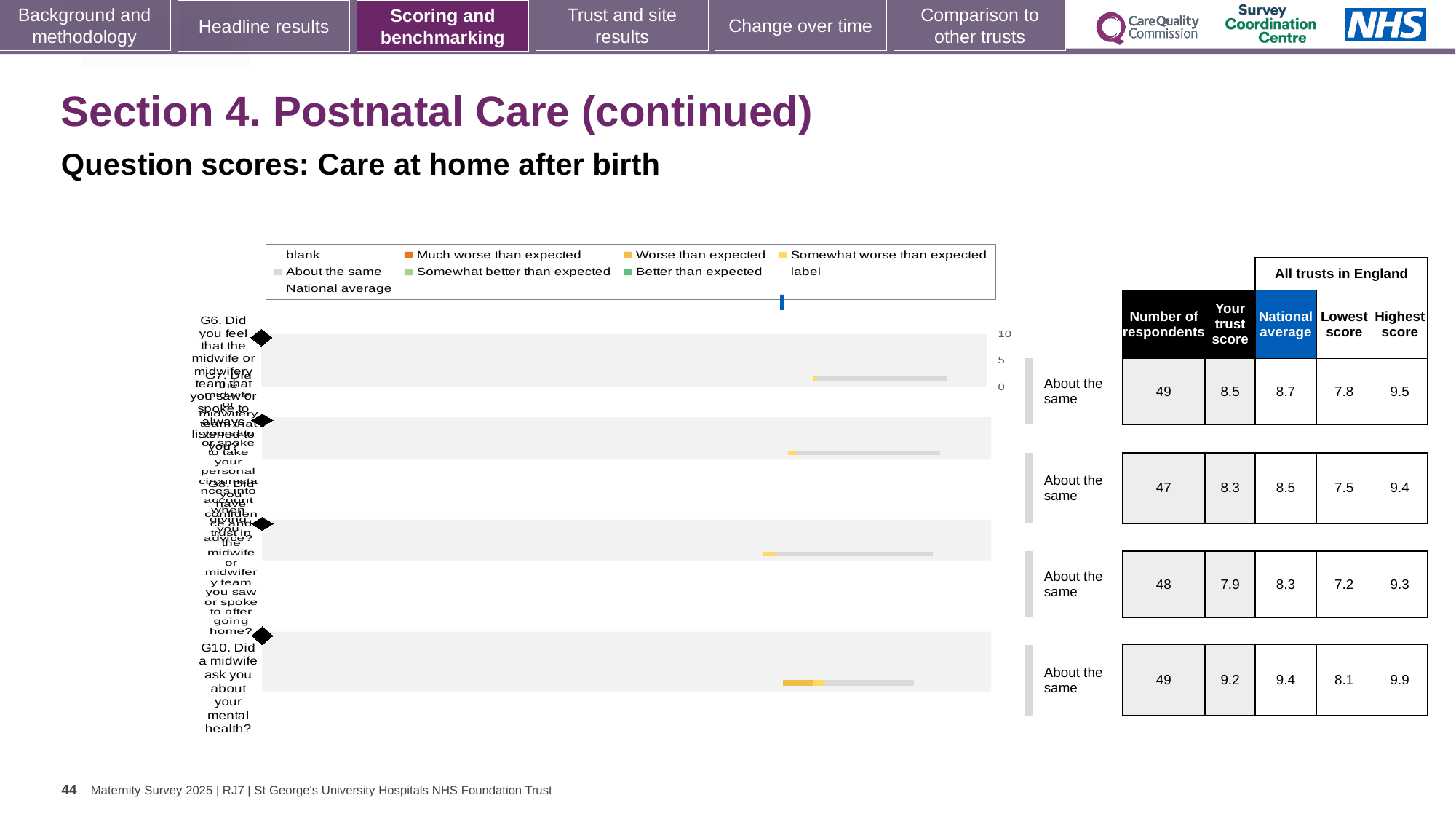
Which question has the highest 'Your trust score' in the table? G10. Did a midwife ask you about your mental health? Which legend entry is shown in dark orange? Much worse than expected What is the highest score among all trusts in England for G10 (Did a midwife ask you about your mental health?)? 9.9 What benchmark category is shown for G10 (Did a midwife ask you about your mental health?)? About the same In the table beside the chart, what is 'Your trust score' for G10 (Did a midwife ask you about your mental health?)? 9.2 How many respondents answered G10 (Did a midwife ask you about your mental health?)? 49 What is the lowest 'Your trust score' value shown in the table? 7.9 What type of chart is shown on the slide? bar chart For G10, which is larger: your trust score or the national average? National average How many survey questions (rows) are plotted in the chart? 4 What is the national average for G10 (Did a midwife ask you about your mental health?)? 9.4 For G10, what is the difference between the national average and your trust score? 0.2